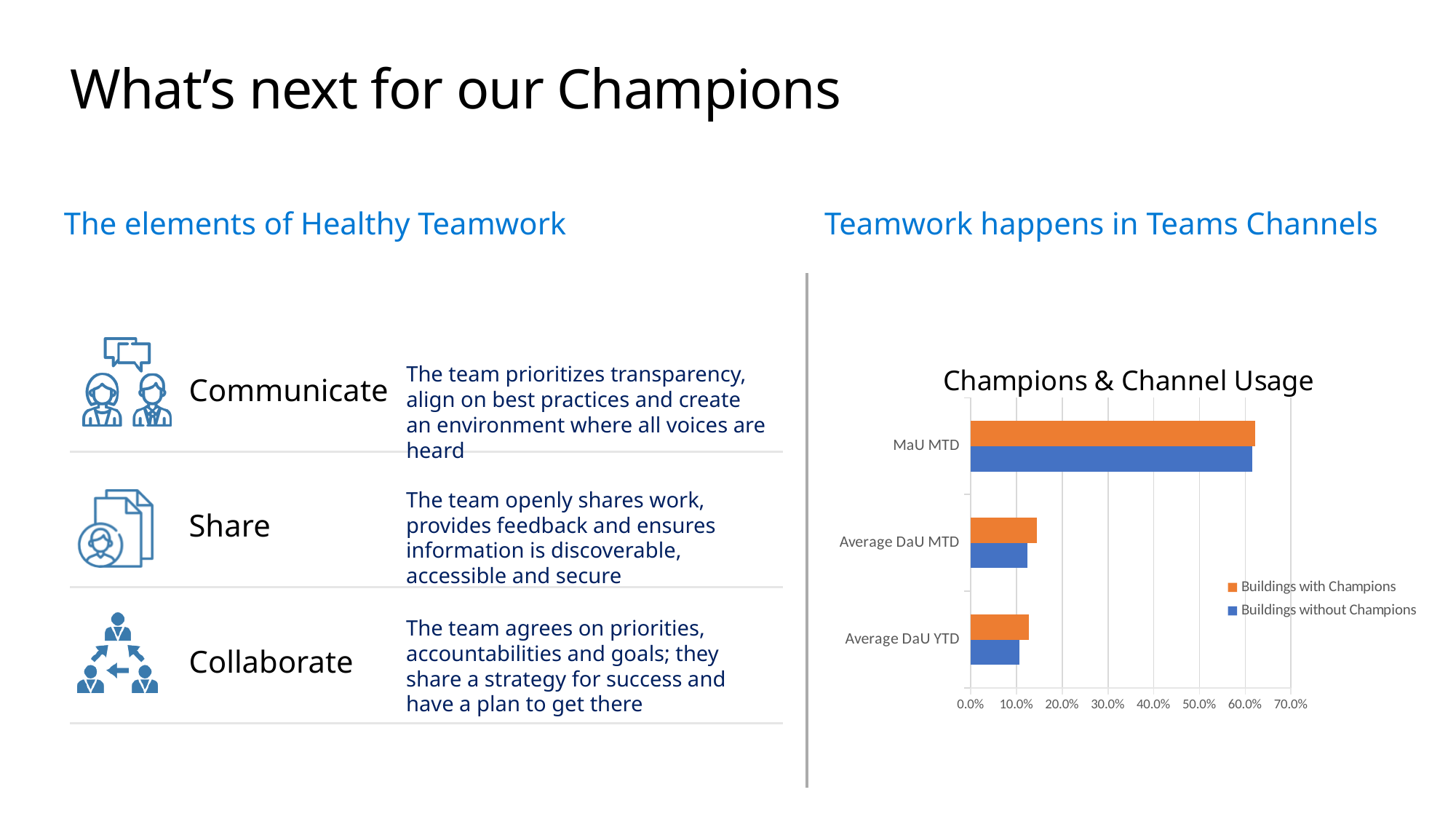
In the Champions & Channel Usage chart, which category has the highest value for Buildings without Champions? MaU MTD What is the title of the chart on the right side of the slide? Champions & Channel Usage In the Champions & Channel Usage chart, is the value for Average DaU MTD for Buildings with Champions greater or less than 10.0%? greater In the Champions & Channel Usage chart, which category has the highest value for Buildings with Champions? MaU MTD What type of chart is shown under "Teamwork happens in Teams Channels"? bar chart In the Champions & Channel Usage chart, for Buildings with Champions, which is larger: MaU MTD or Average DaU MTD? MaU MTD How many series does the legend of the Champions & Channel Usage chart list? 2 In the Champions & Channel Usage chart, which colour represents Buildings with Champions? orange In the Champions & Channel Usage chart, is the value for MaU MTD for Buildings with Champions greater or less than 60.0%? greater In the Champions & Channel Usage chart, is the value for MaU MTD for Buildings with Champions greater or less than 70.0%? less How many categories are shown on the Champions & Channel Usage chart? 3